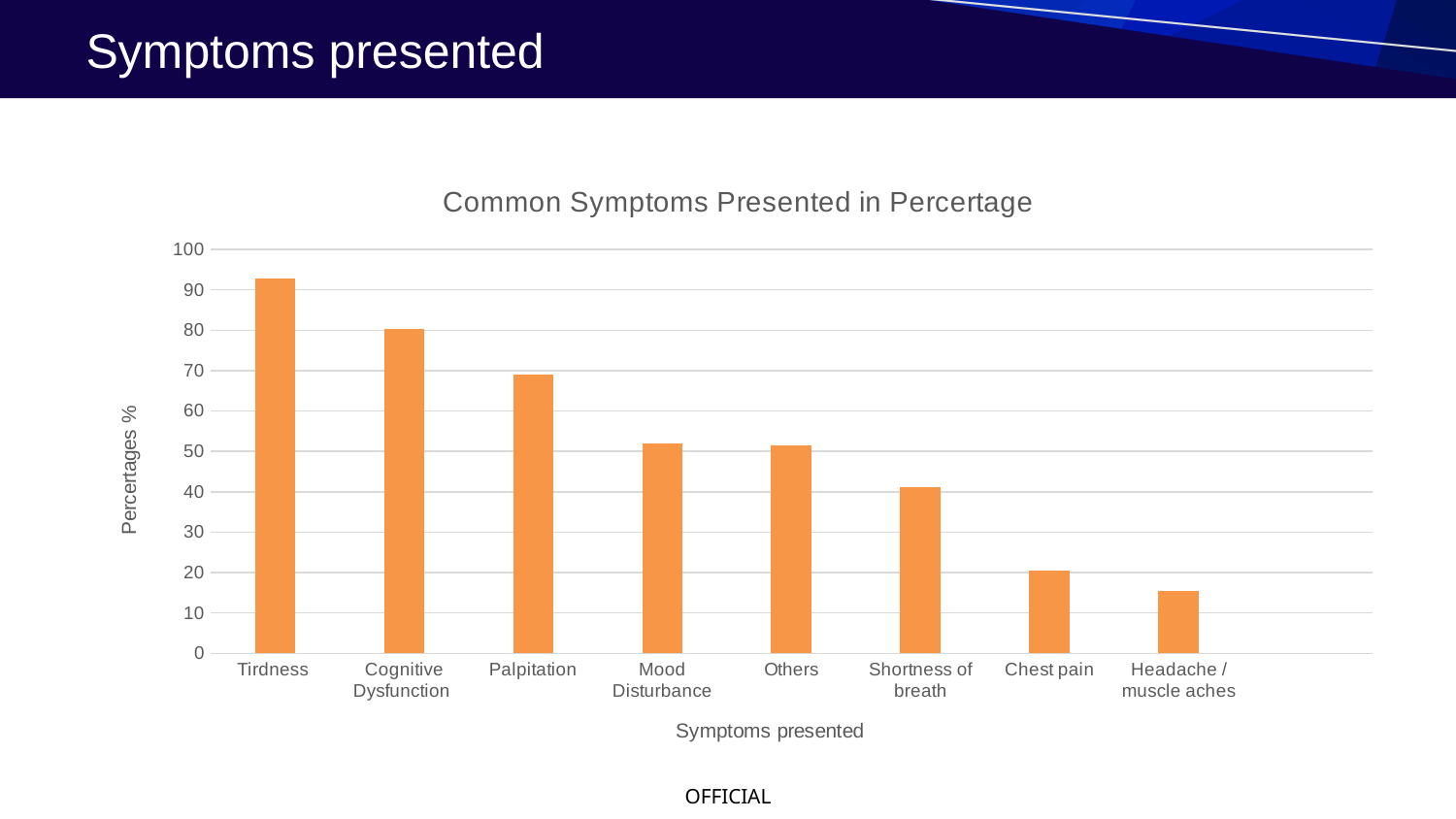
Is the value for Tirdness greater or less than 90? greater Which is larger, the value for Chest pain or the value for Shortness of breath? Shortness of breath Do the values rise or fall from left to right along the x axis? Fall Is the value for Palpitation greater or less than 60? greater Is the value for Chest pain greater or less than 30? less Which symptom has the lowest percentage in the chart? Headache / muscle aches Which symptom has the highest percentage in the chart? Tirdness What kind of chart is shown on the slide? Bar chart How many symptom categories are shown on the x axis? 8 Which is larger, the value for Palpitation or the value for Mood Disturbance? Palpitation